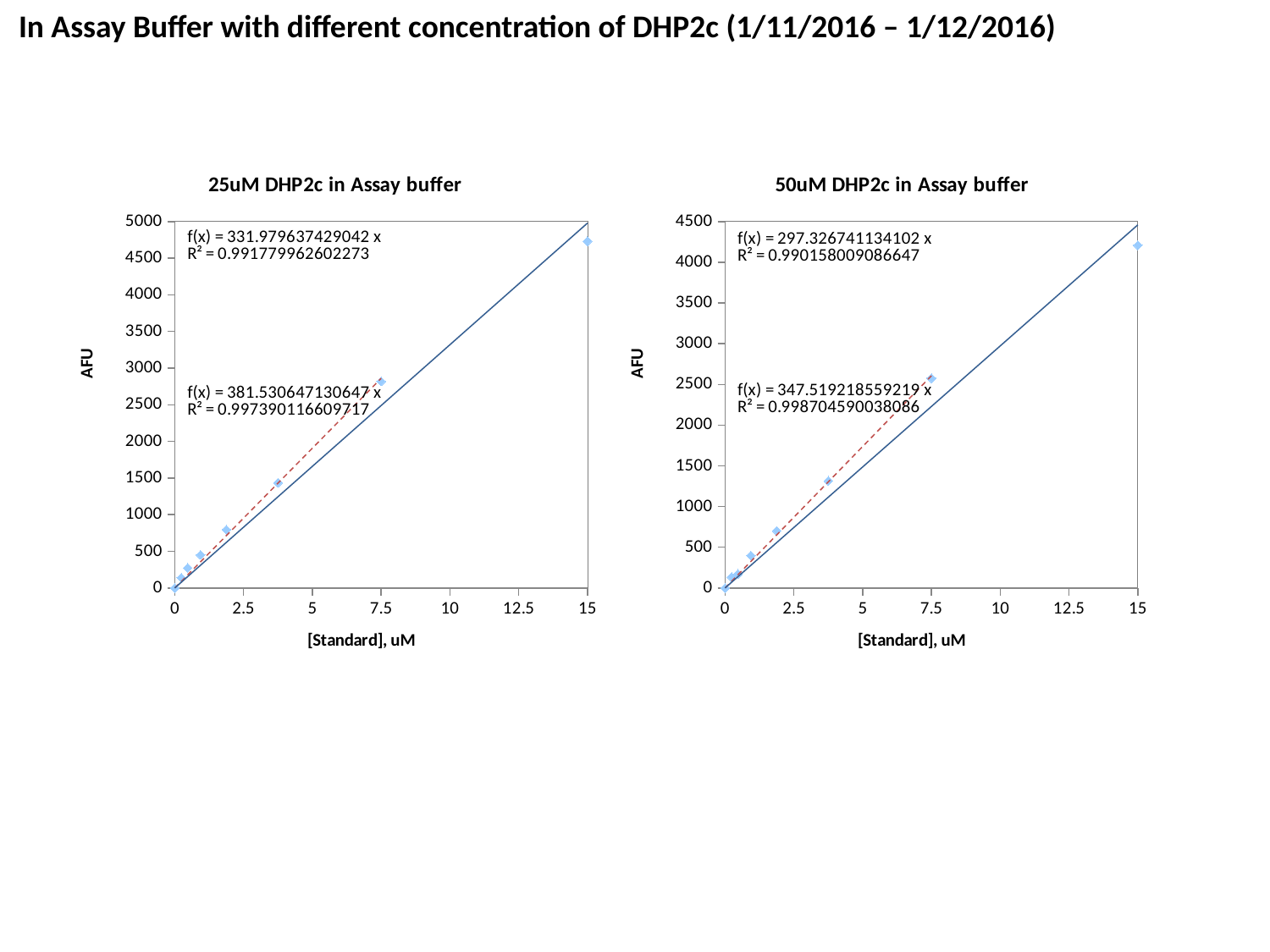
In the '25uM DHP2c in Assay buffer' chart, is the AFU value at 7.5 uM greater or less than 2500? greater In the '25uM DHP2c in Assay buffer' chart, is the AFU value at 15 uM greater or less than 4500? greater In the '50uM DHP2c in Assay buffer' chart, which has the higher AFU value: the point at 7.5 uM or the point at 3.75 uM? 7.5 uM In the '50uM DHP2c in Assay buffer' chart, is the AFU value at 3.75 uM greater or less than 1000? greater What kind of chart is the '25uM DHP2c in Assay buffer' chart? scatter chart In the '25uM DHP2c in Assay buffer' chart, do the AFU values rise or fall as the standard concentration increases? rise What is the title of the chart on the right side of the slide? 50uM DHP2c in Assay buffer In the '50uM DHP2c in Assay buffer' chart, do the AFU values rise or fall as the standard concentration increases? rise What is the x-axis label on the '25uM DHP2c in Assay buffer' chart? [Standard], uM